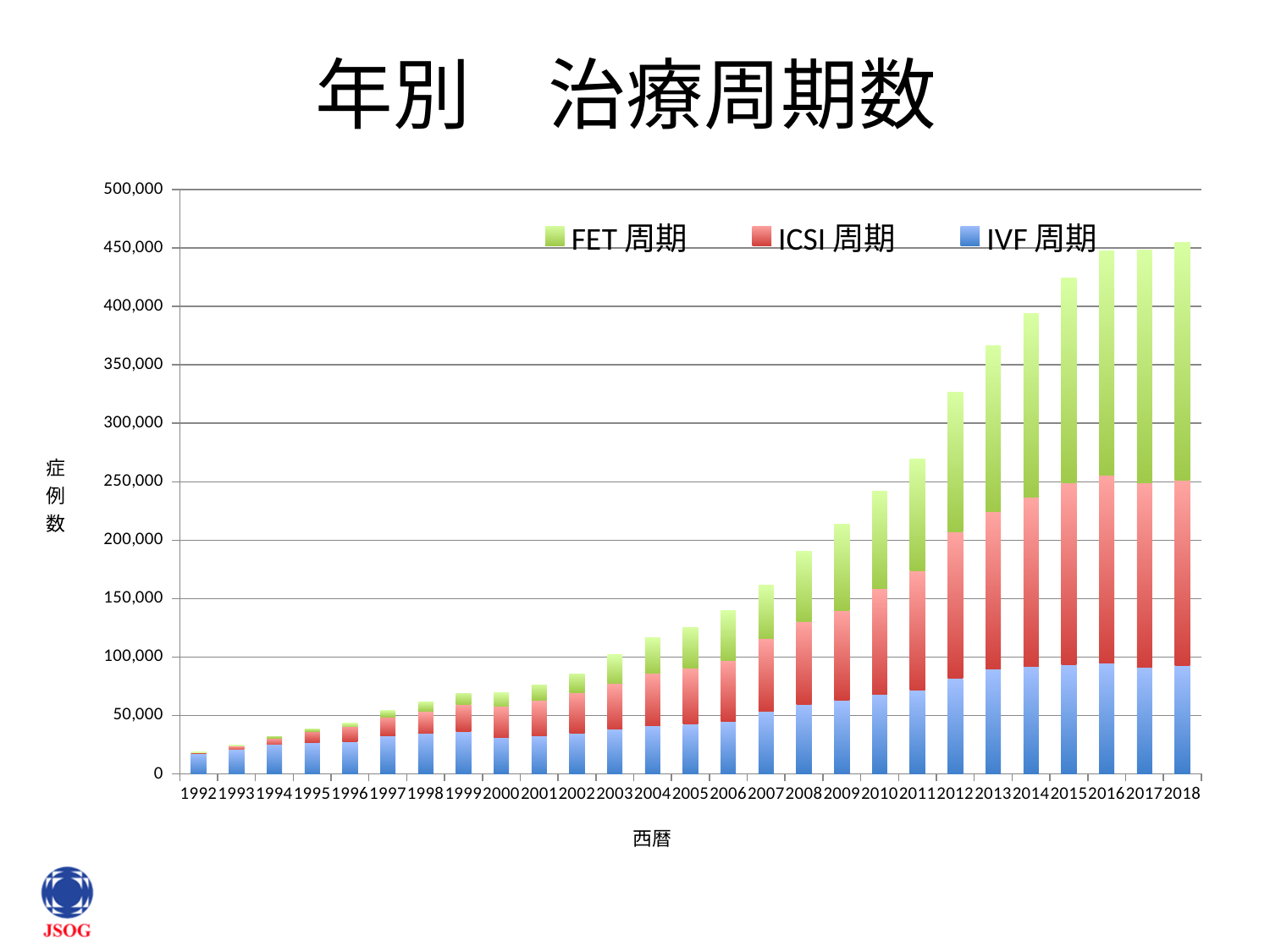
Is the total bar height for 1992 greater or less than 50,000? less How many years are shown along the x axis? 27 Do the total treatment cycle counts generally rise or fall from 1992 to 2018? rise Is the total bar height for 2018 greater or less than 400,000? greater How many series does the legend list? 3 What kind of chart is shown on the slide? bar chart Which year has the lowest total number of treatment cycles? 1992 What is the title of the chart? 年別 治療周期数 Is the total bar height for 2008 greater or less than 200,000? less Which year has a larger total bar, 2009 or 2013? 2013 What are the three legend entries of the chart? FET 周期, ICSI 周期, IVF 周期